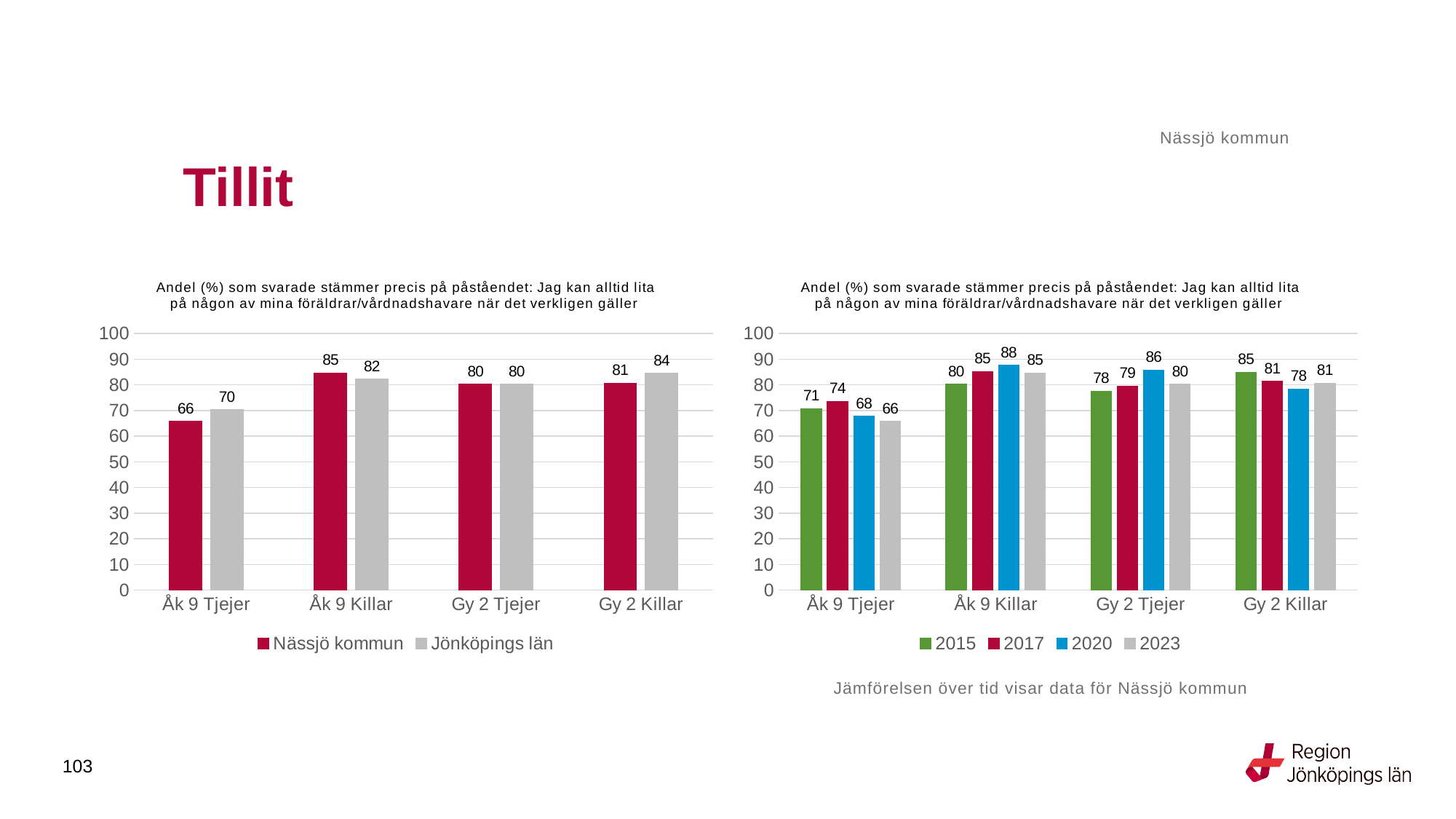
In the right chart, what is the value for 2023 for Åk 9 Tjejer? 66 In the left chart, which category has the highest value for Nässjö kommun? Åk 9 Killar In the left chart, what is the difference between Jönköpings län and Nässjö kommun for Åk 9 Tjejer? 4 In the right chart, how many series does the legend list? 4 In the left chart, what is the value for Jönköpings län for Gy 2 Killar? 84 In the right chart, what is the value for 2020 for Åk 9 Killar? 88 In the right chart, is the value for 2015 for Gy 2 Tjejer larger or smaller than the value for 2020 for Gy 2 Tjejer? Smaller In the right chart, which year has the lowest value for Gy 2 Killar? 2020 In the left chart, what is the value for Nässjö kommun for Åk 9 Tjejer? 66 In the right chart, how many categories are shown on the x axis? 4 In the left chart, how many series does the legend list? 2 In the left chart, what kind of chart is shown? Bar chart